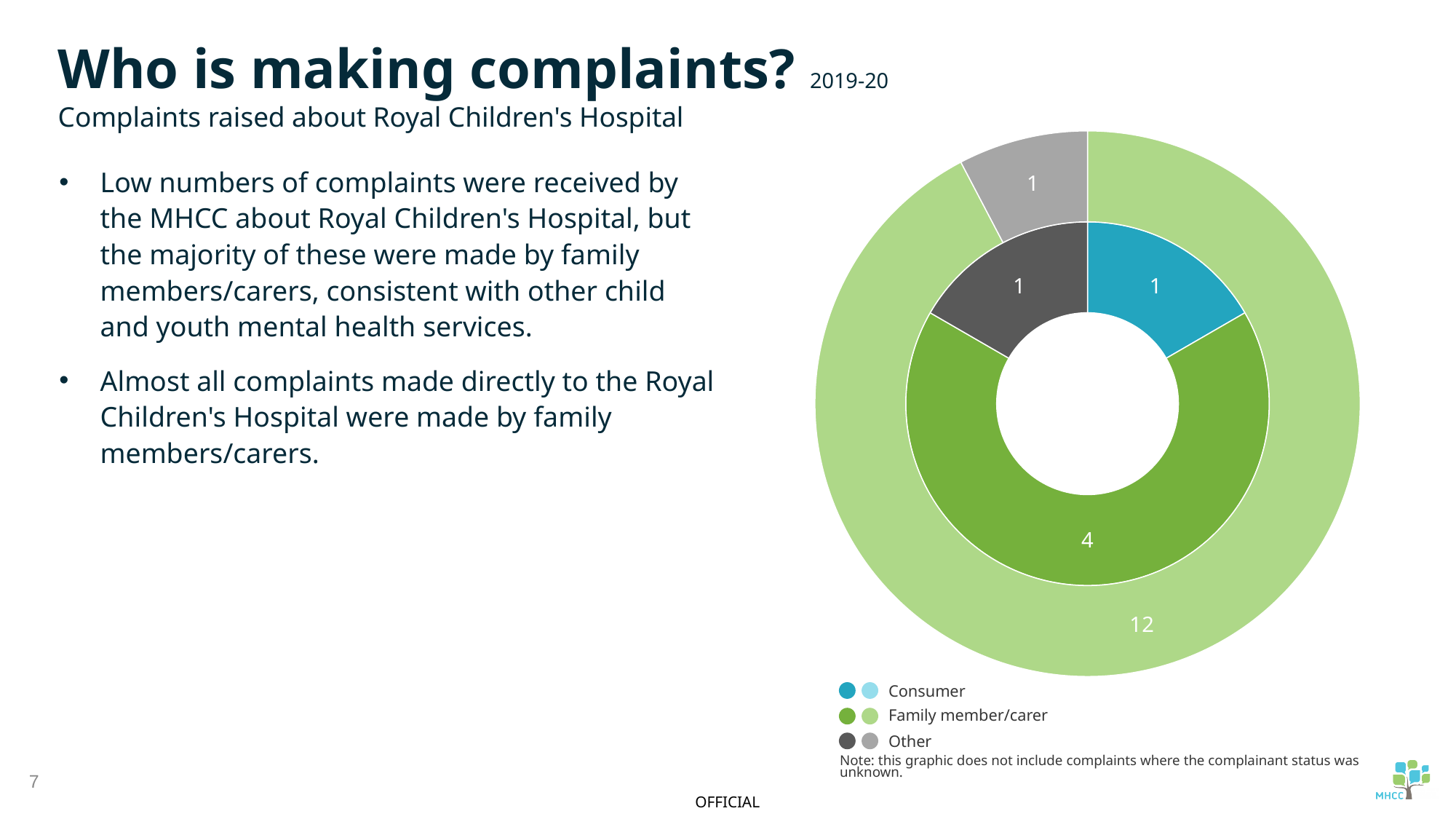
What kind of chart is shown on the slide? doughnut chart What is the difference between the Family member/carer value in the outer ring and the Family member/carer value in the inner ring? 8 What is the value for Other in the outer ring of the doughnut chart? 1 What is the value for Consumer in the inner ring of the doughnut chart? 1 What is the value for Family member/carer in the inner ring of the doughnut chart? 4 What is the value for Family member/carer in the outer ring of the doughnut chart? 12 Which is larger in the inner ring: Family member/carer or Consumer? Family member/carer How many categories does the chart legend list? 3 What is the value for Other in the inner ring of the doughnut chart? 1 What is the total of all values in the inner ring of the doughnut chart? 6 Which category has the largest value in the inner ring of the doughnut chart? Family member/carer Which category has the largest value in the outer ring of the doughnut chart? Family member/carer